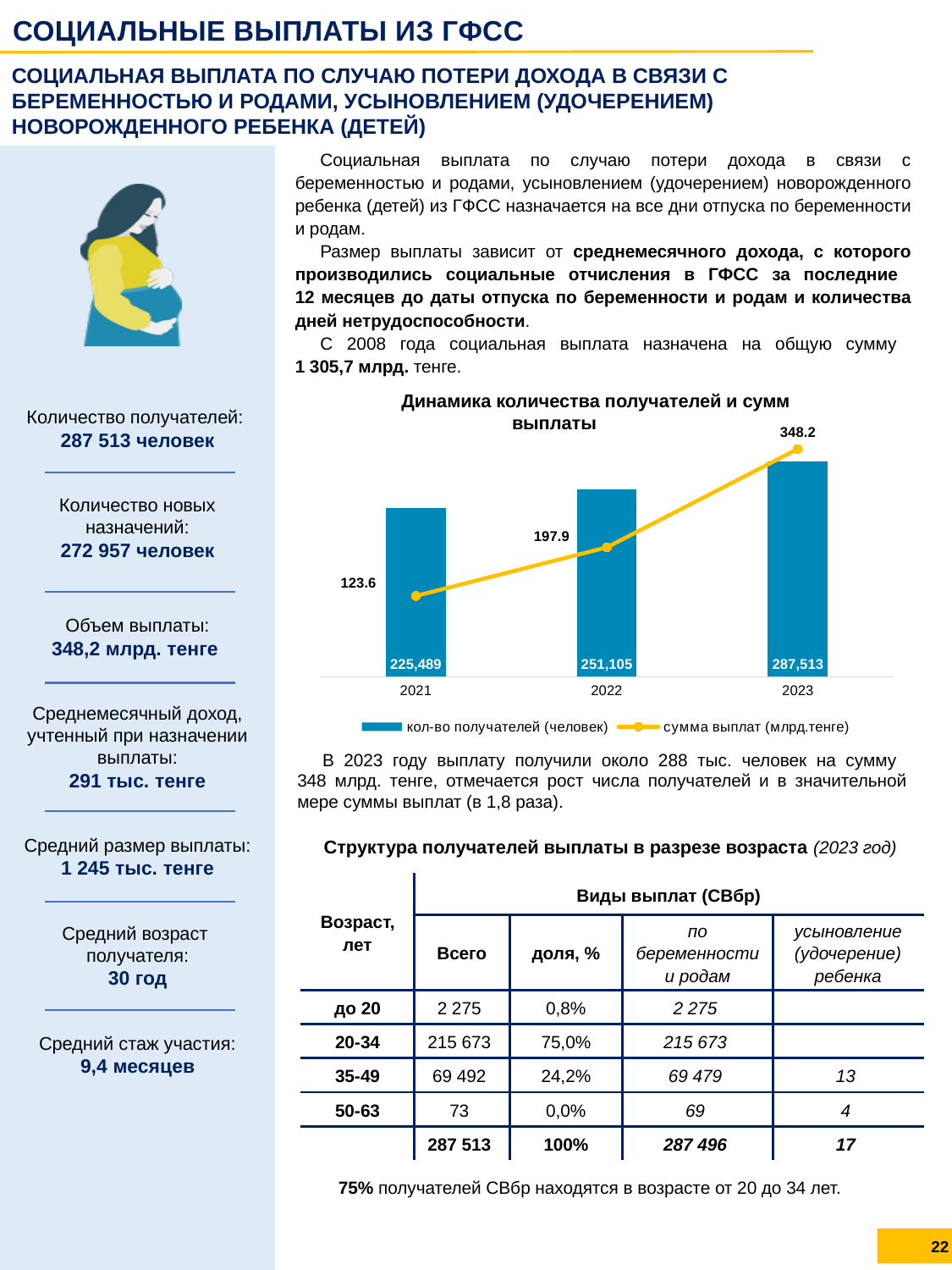
What is the sum of payments (сумма выплат, млрд.тенге) shown for 2021 in the chart? 123.6 Which year has the lowest number of recipients in the chart? 2021 By how much did the number of recipients increase from 2021 to 2023 according to the chart? 62,024 How many years are shown on the x axis of the chart? 3 What is the sum of payments (млрд.тенге) shown for 2022 in the chart? 197.9 How many series does the chart's legend list? 2 What is the number of recipients (кол-во получателей) shown for 2023 in the chart? 287,513 What is the difference between the sum of payments in 2023 and in 2022 in the chart? 150.3 Does the sum of payments rise or fall from 2021 to 2023 in the chart? rise Which year has the highest sum of payments in the chart? 2023 Is the sum of payments larger in 2021 or in 2022 according to the chart? 2022 What is the number of recipients shown for 2022 in the chart? 251,105